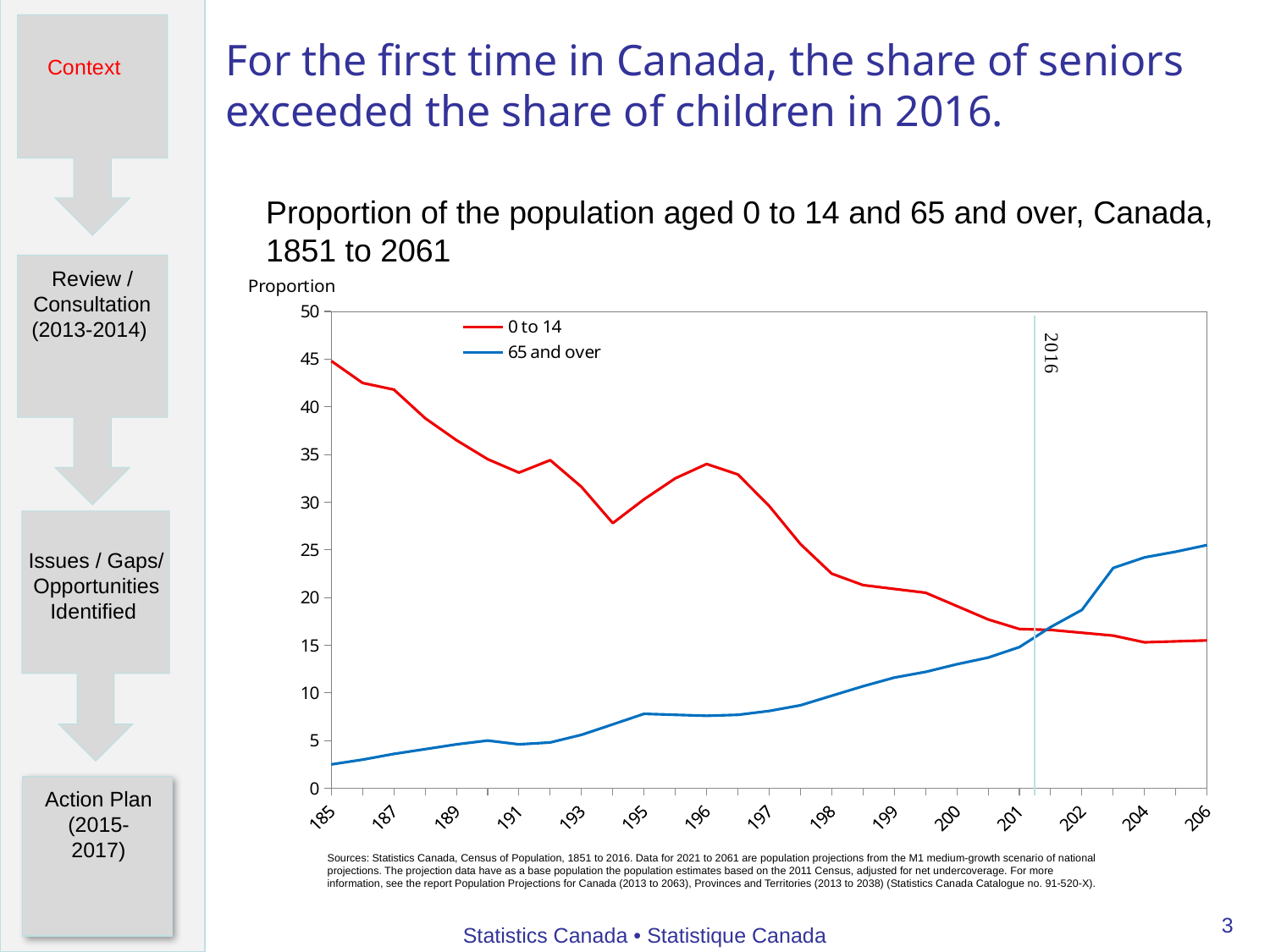
At the left end of the chart, which series has the higher value, 0 to 14 or 65 and over? 0 to 14 What year does the vertical line on the chart mark? 2016 At the right end of the chart, which series has the higher value, 0 to 14 or 65 and over? 65 and over What are the two series named in the chart's legend? 0 to 14 and 65 and over Does the 0 to 14 line rise or fall overall from left to right along the x axis? fall Does the 65 and over line rise or fall overall from left to right along the x axis? rise What kind of chart is shown on the slide? line chart At the left end of the chart, is the value for 0 to 14 greater or less than 40? greater At the left end of the chart, is the value for 65 and over greater or less than 5? less At the right end of the chart, is the value for 0 to 14 greater or less than 20? less How many series does the chart's legend list? 2